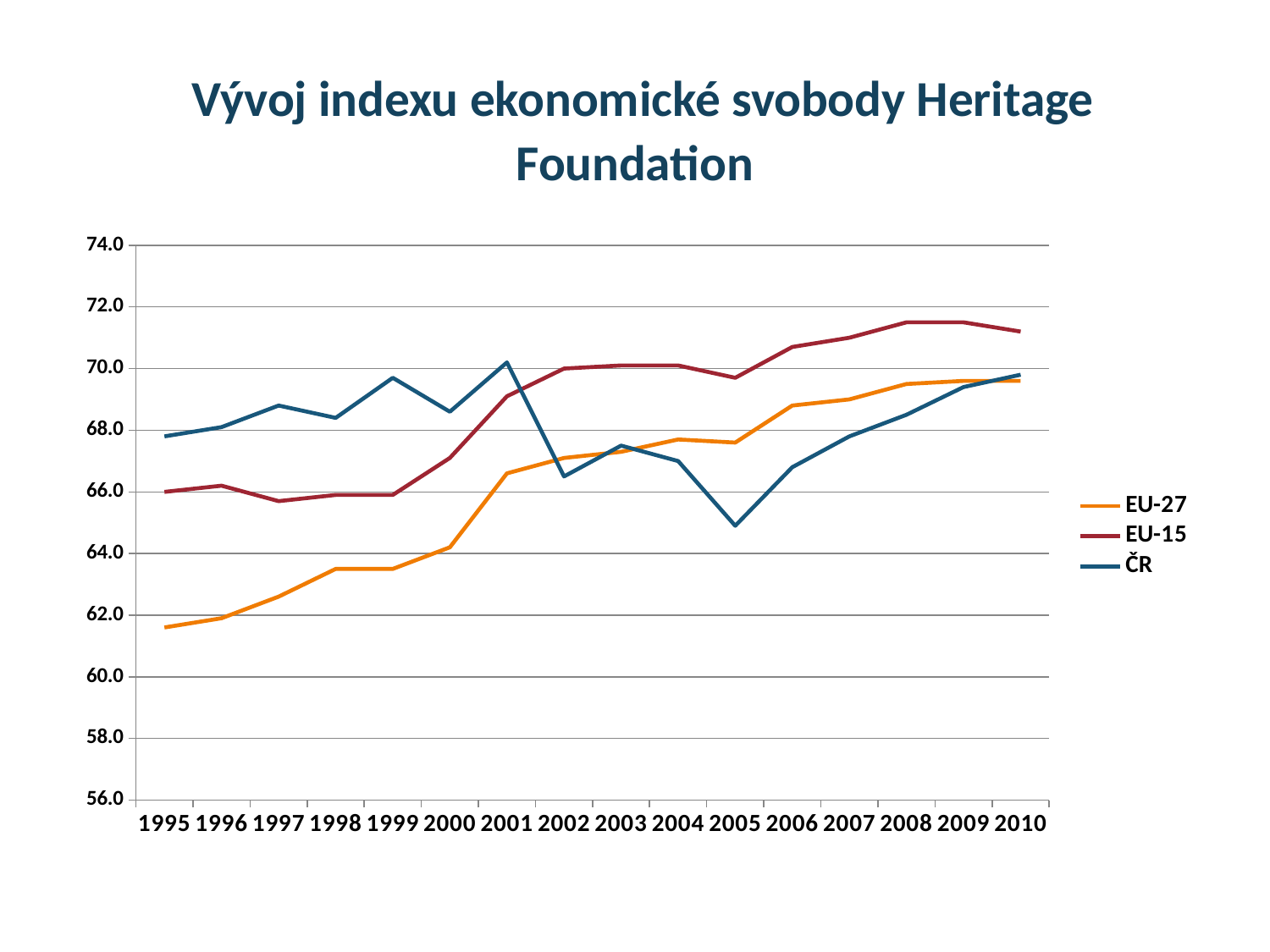
In 2005, which is larger: the value for ČR or the value for EU-27? EU-27 Is the value for ČR in 2005 greater or less than 66.0? less In which year does the ČR series reach its lowest value? 2005 How many years are shown on the x axis? 16 Is the value for EU-15 in 2008 greater or less than 70.0? greater What kind of chart is shown on the slide? line chart Does the EU-27 series generally rise or fall from 1995 to 2010? rise Is the value for EU-27 in 1995 greater or less than 62.0? less What is the title of the chart? Vývoj indexu ekonomické svobody Heritage Foundation How many series does the legend list? 3 Which series has the lowest value in 1995? EU-27 Which series has the highest value in 2010? EU-15